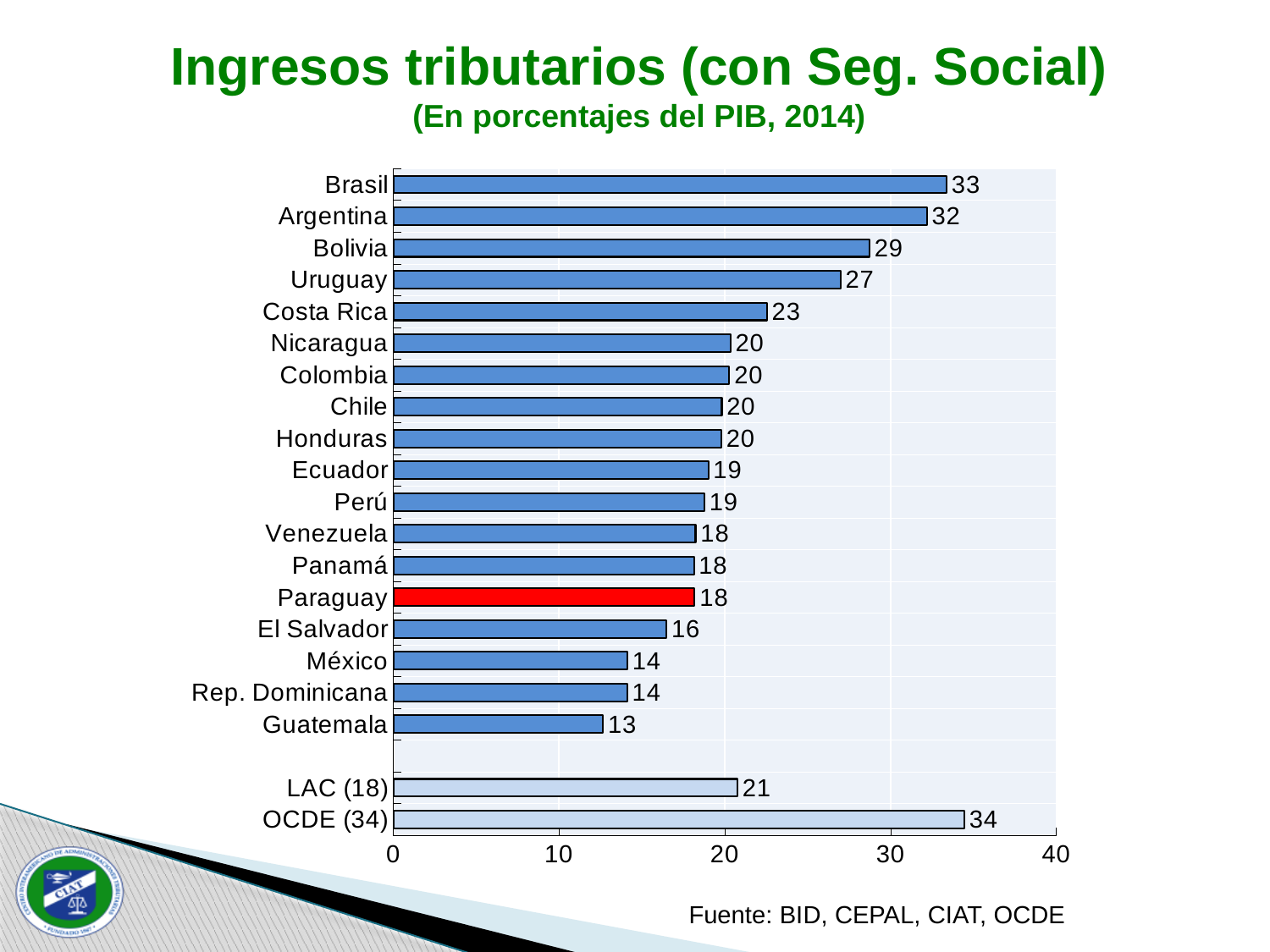
What is the difference between the values for Brasil and Guatemala? 20 Which bar has the highest value on the chart? OCDE (34) What is the value shown for Brasil? 33 Which has a larger value, Uruguay or Costa Rica? Uruguay What is the value shown for LAC (18)? 21 How many bars are plotted on the chart? 20 What is the value shown for OCDE (34)? 34 What is the difference between the values for OCDE (34) and LAC (18)? 13 What kind of chart is shown on the slide? Bar chart Which bar is highlighted in red on the chart? Paraguay Which country has the lowest value on the chart? Guatemala What is the value shown for Paraguay? 18